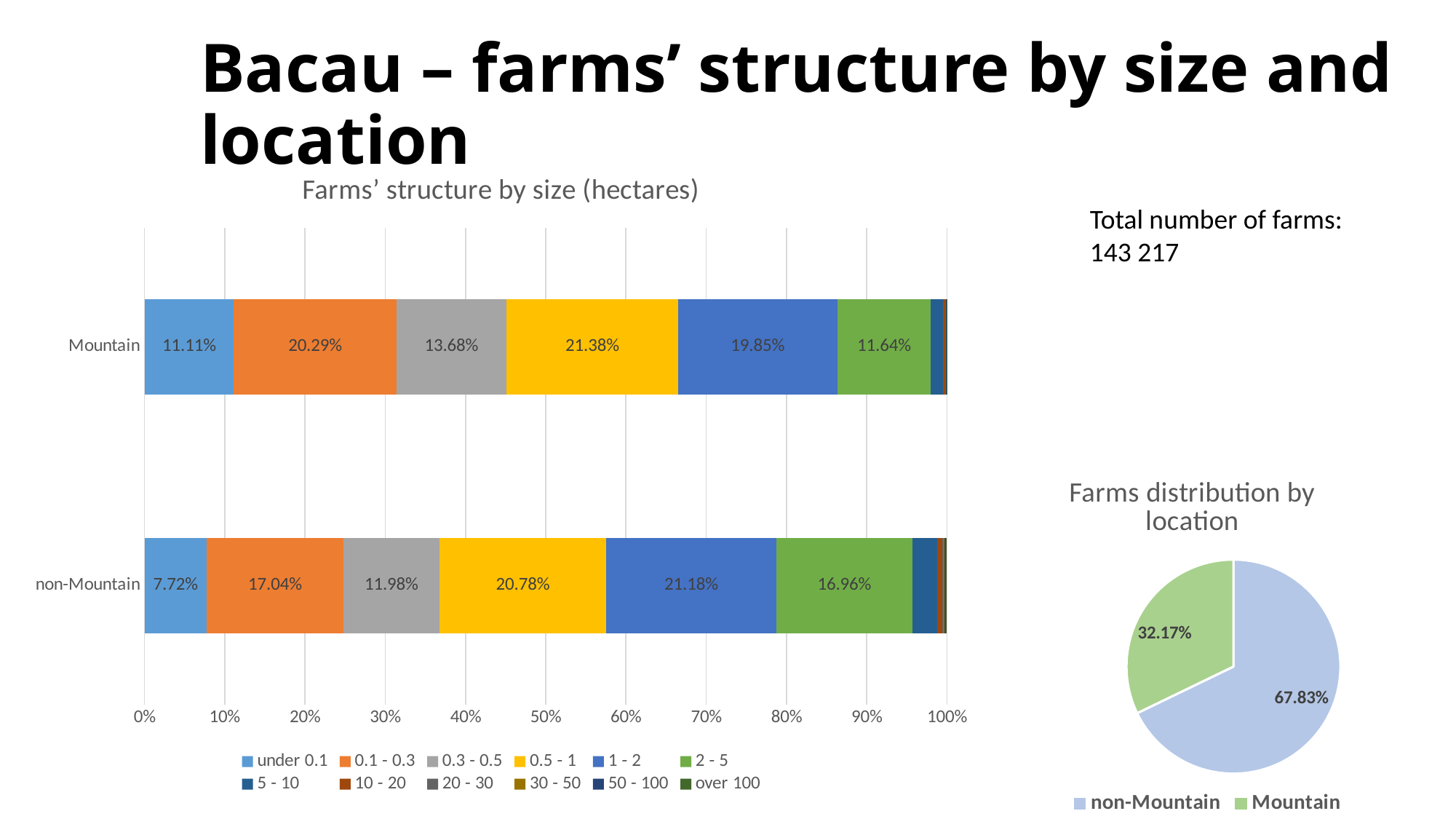
In the 'Farms' structure by size (hectares)' chart, is the '0.3 - 0.5' value larger for Mountain or non-Mountain? Mountain In the 'Farms' structure by size (hectares)' chart, what is the value for the 'under 0.1' series for Mountain? 11.11% In the 'Farms' structure by size (hectares)' chart, which size class has the largest labelled share for Mountain? 0.5 - 1 How many series does the legend of the 'Farms' structure by size (hectares)' chart list? 12 What kind of chart is 'Farms distribution by location'? Pie chart What kind of chart is 'Farms' structure by size (hectares)'? Stacked bar chart In the 'Farms distribution by location' pie chart, what is the difference between the non-Mountain and Mountain shares? 35.66% In the 'Farms distribution by location' pie chart, what share is non-Mountain? 67.83% In the 'Farms' structure by size (hectares)' chart, what is the value for the '0.5 - 1' series for Mountain? 21.38% In the 'Farms' structure by size (hectares)' chart, what is the value for the '2 - 5' series for non-Mountain? 16.96% In the 'Farms' structure by size (hectares)' chart, what is the difference between the '0.1 - 0.3' values for Mountain and non-Mountain? 3.25% In the 'Farms' structure by size (hectares)' chart, which size class has the largest labelled share for non-Mountain? 1 - 2